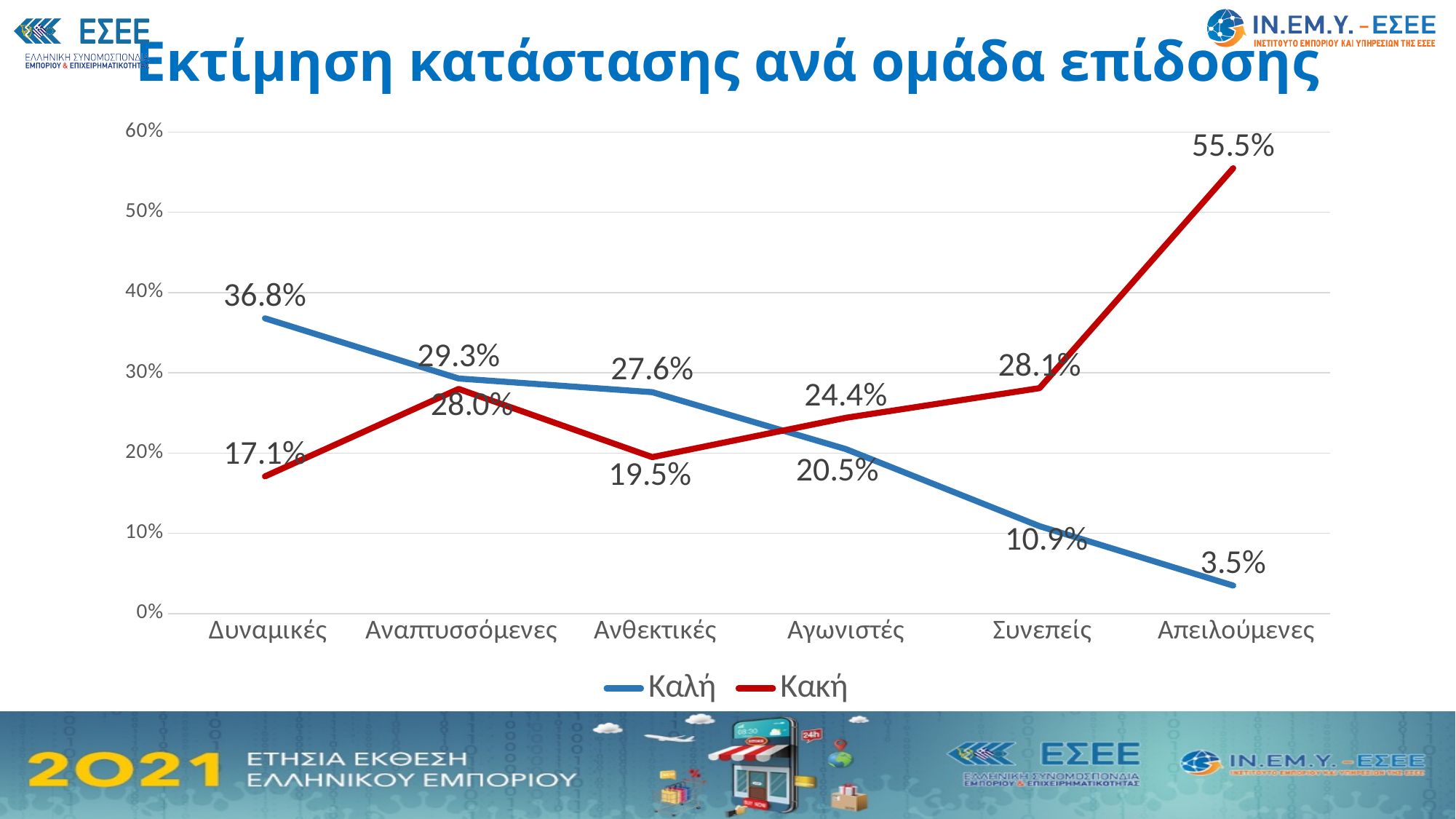
What colour is the line for the Κακή series? red How many series does the legend list? 2 Which category has the lowest value for Καλή? Απειλούμενες Which category has the highest value for Κακή? Απειλούμενες What is the value of Καλή for Δυναμικές? 36.8% What is the value of Κακή for Ανθεκτικές? 19.5% What is the value of Κακή for Απειλούμενες? 55.5% What is the difference between Κακή and Καλή for Απειλούμενες? 52.0% What kind of chart is shown on the slide? line chart Does the Καλή series rise or fall from Δυναμικές to Απειλούμενες? fall How many categories are shown on the x axis? 6 Which is larger for Συνεπείς, Καλή or Κακή? Κακή